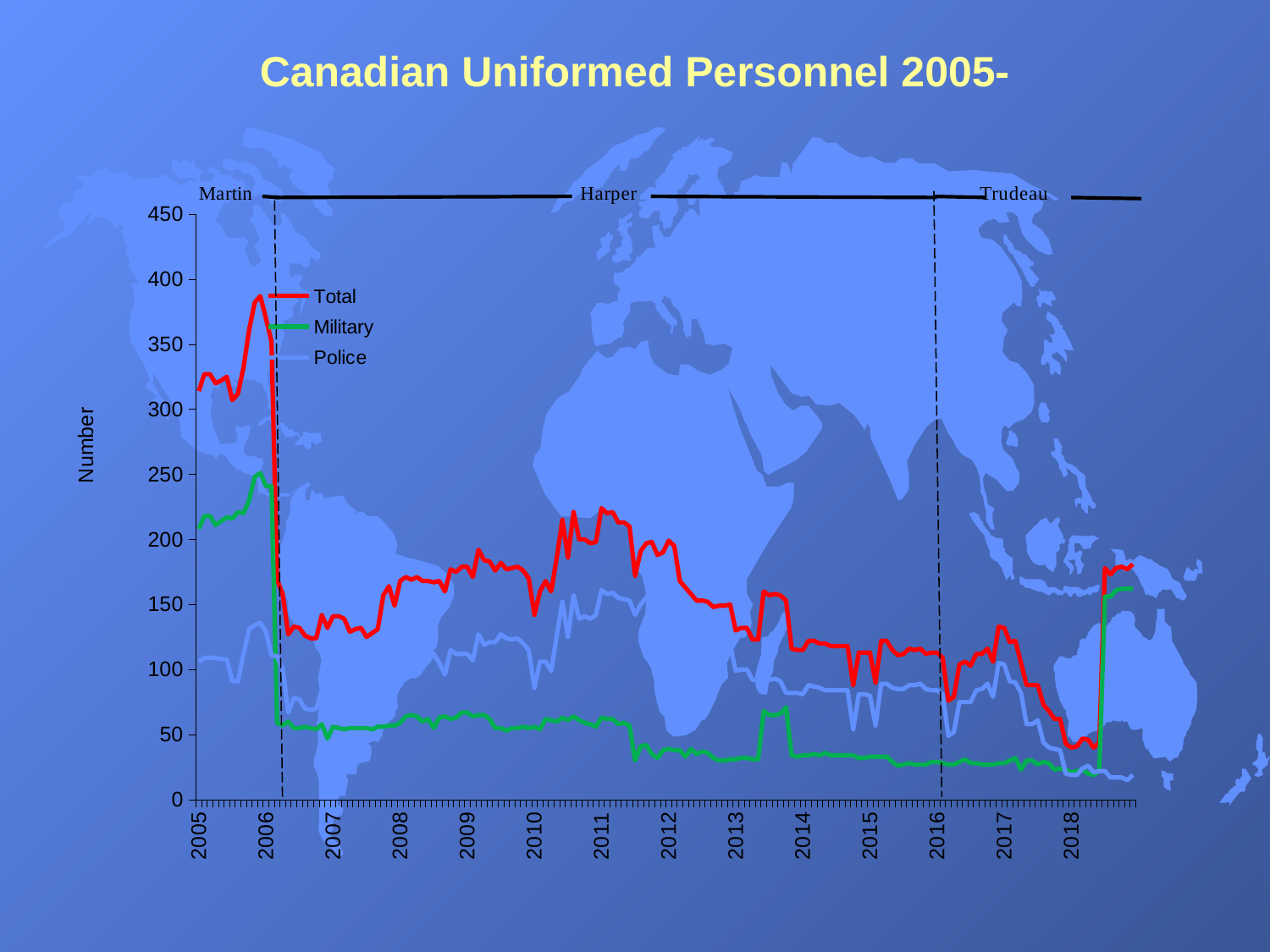
Is the value for Total in early 2018 greater or less than 100? less Which is higher in 2009, Military or Police? Police What label is shown on the vertical axis? Number Which is higher in 2010, Total or Military? Total Is the value for Military at the start of 2005 greater or less than 200? greater How many series does the legend list? 3 What is the title of the chart? Canadian Uniformed Personnel 2005- Is the value for Total at the start of 2005 greater or less than 300? greater What kind of chart is shown on the slide? line chart Does the Total series generally rise or fall from 2011 to early 2018? fall